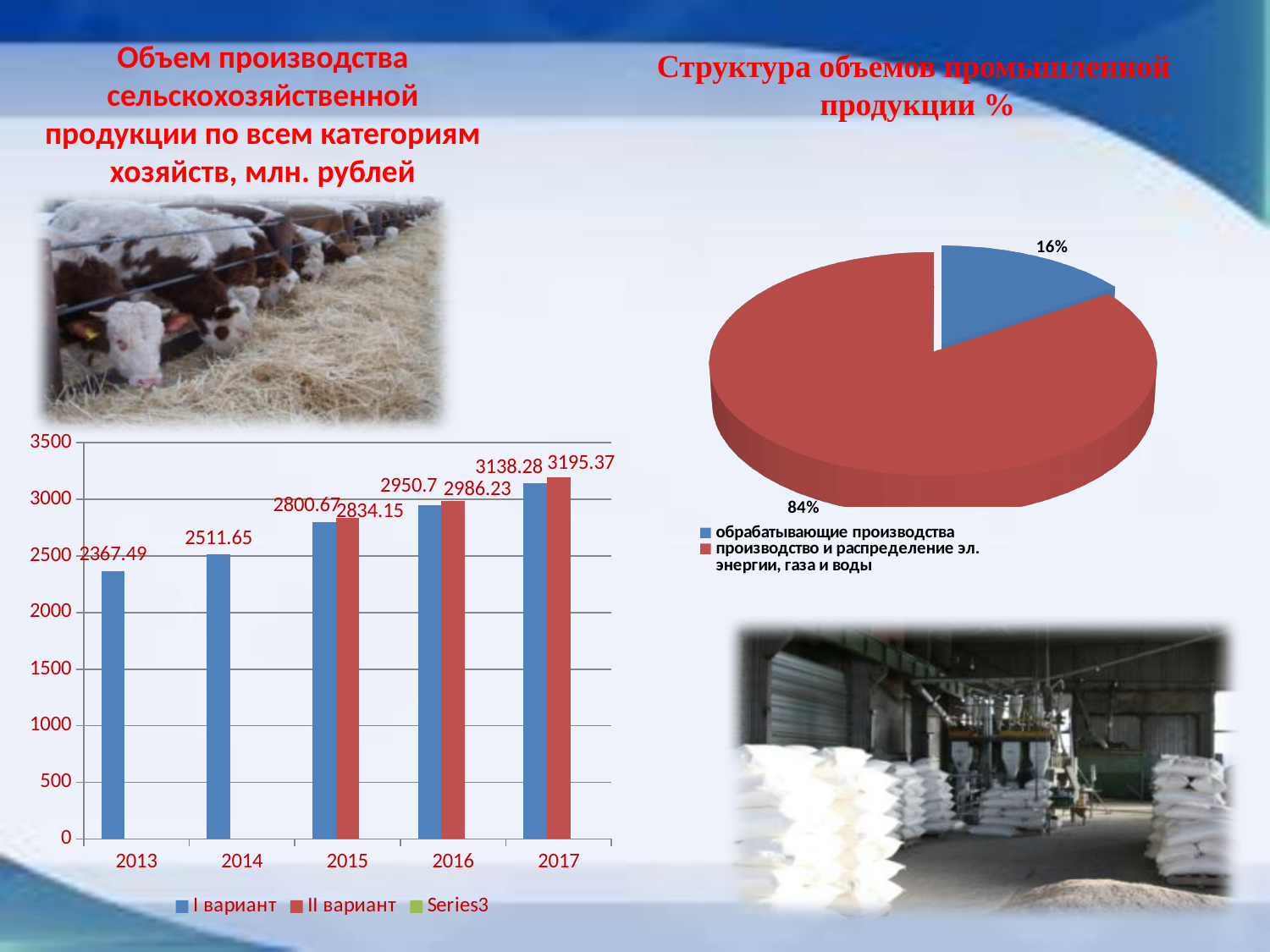
What type of chart is the chart on the left of the slide? bar chart In the pie chart 'Структура объемов промышленной продукции %', which category has the 84% share? производство и распределение эл. энергии, газа и воды In the bar chart on the left, how many series does the legend list? 3 In the bar chart on the left, which is larger in 2015: I вариант or II вариант? II вариант In the bar chart on the left, what is the value of II вариант for 2017? 3195.37 In the pie chart 'Структура объемов промышленной продукции %', what share does обрабатывающие производства have? 16% In the bar chart on the left, what is the value of I вариант for 2016? 2950.7 In the bar chart on the left, do the values of I вариант rise or fall from 2013 to 2017? rise In the bar chart on the left, how many years are shown on the x axis? 5 In the bar chart on the left, what is the value of I вариант for 2013? 2367.49 In the bar chart on the left, which year has the highest value for I вариант? 2017 In the bar chart on the left, what is the difference between II вариант and I вариант in 2017? 57.09